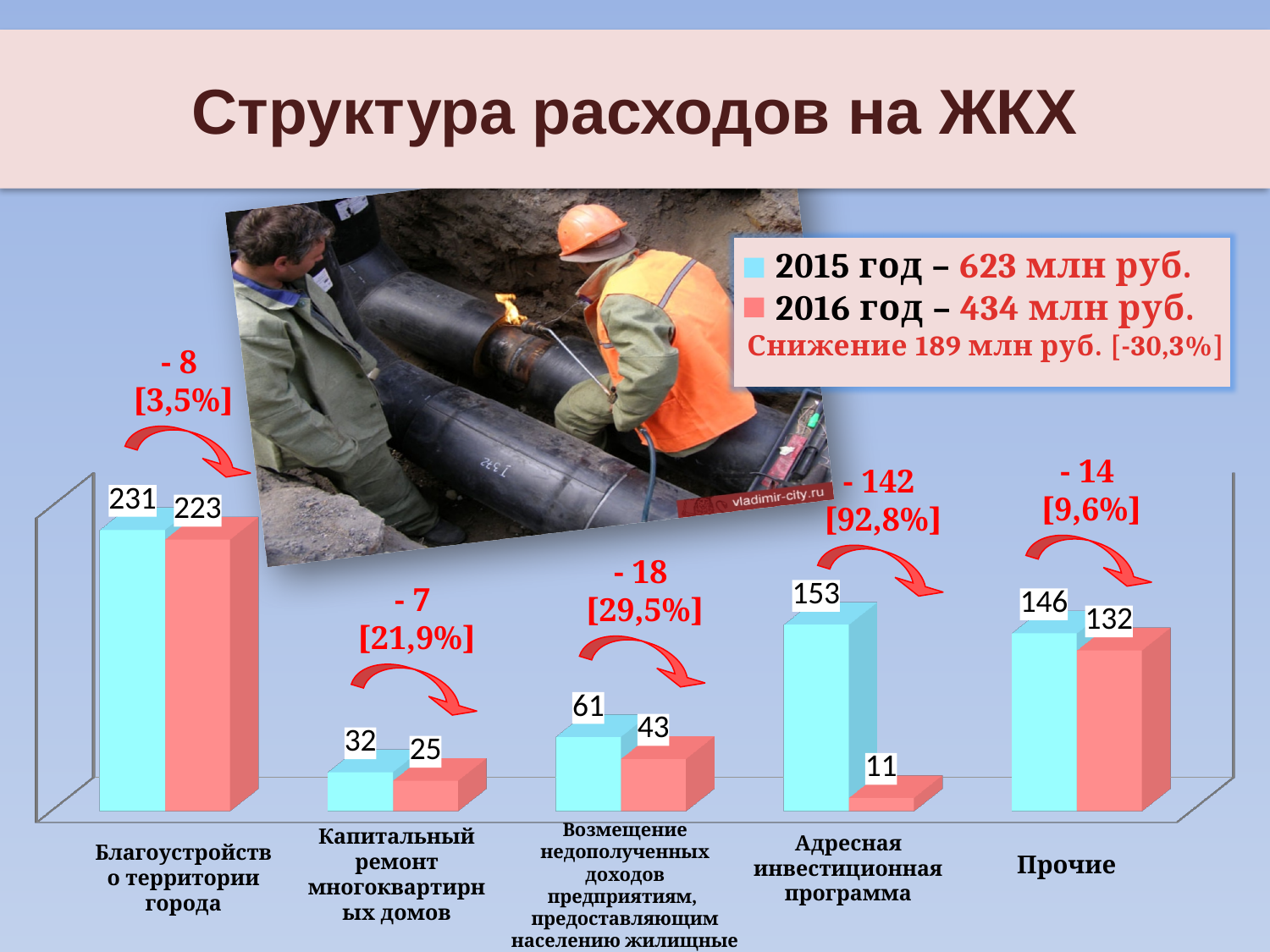
Which category has the highest 2015 value? Благоустройство территории города What is the difference between the 2015 and 2016 values for «Адресная инвестиционная программа»? 142 What is the 2015 value for «Капитальный ремонт многоквартирных домов»? 32 What is the 2016 value for «Адресная инвестиционная программа»? 11 How many categories are shown on the chart? 5 What is the 2015 value for «Благоустройство территории города»? 231 What is the 2016 value for «Прочие»? 132 How many series does the legend list? 2 What kind of chart is shown on the slide? Bar chart Which category has the lowest 2016 value? Адресная инвестиционная программа According to the legend, what is the total for 2016 год? 434 млн руб. Which is larger: the 2016 value for «Прочие» or the 2016 value for «Благоустройство территории города»? Благоустройство территории города